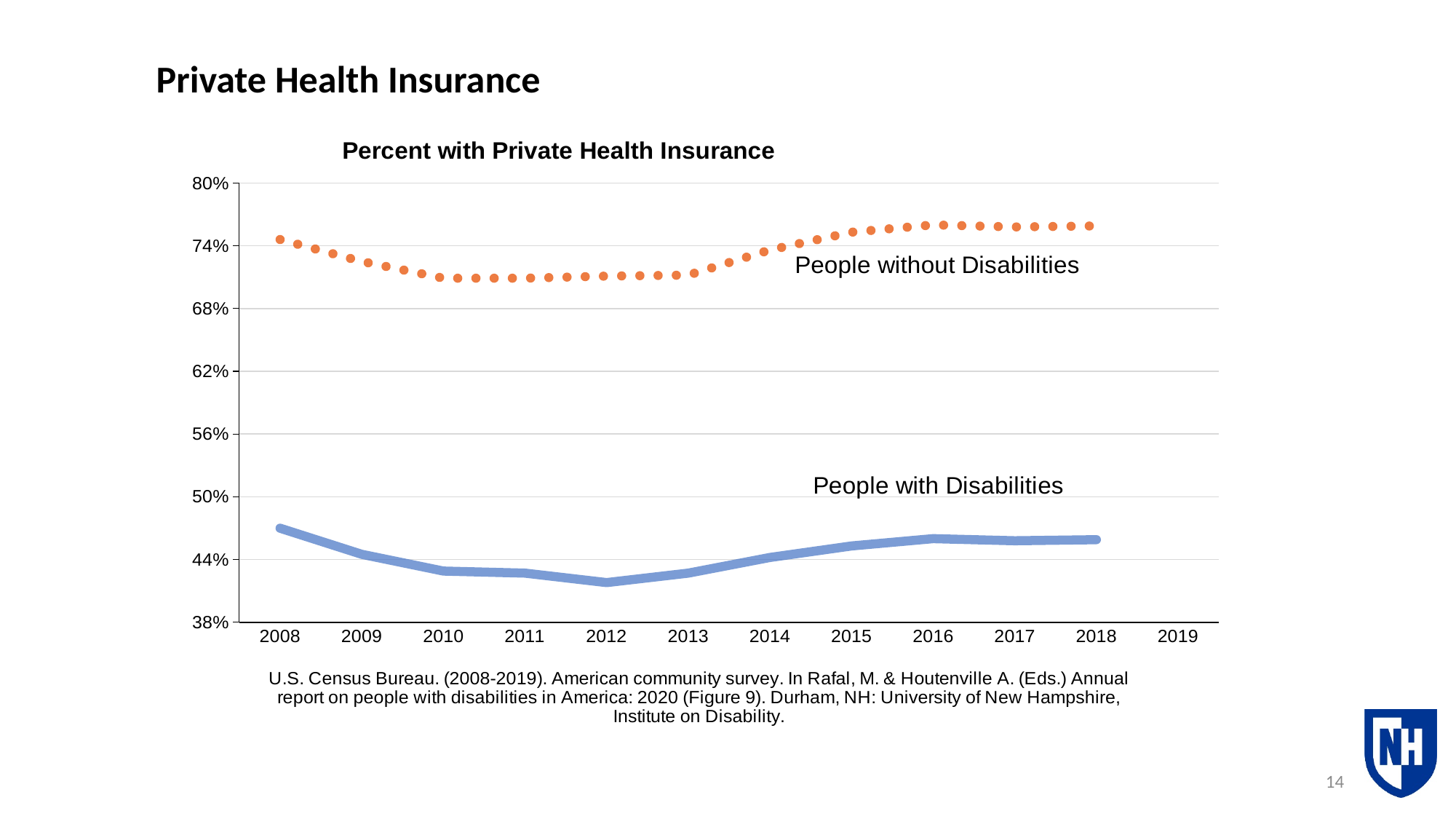
Does the People with Disabilities line rise or fall from 2008 to 2012? fall Is the value for People with Disabilities in 2008 greater or less than 44%? greater How many years are labeled on the x axis? 12 Is the value for People without Disabilities in 2010 greater or less than 74%? less Is the value for People with Disabilities in 2012 greater or less than 44%? less Which series is drawn with a dotted orange line? People without Disabilities What kind of chart is shown on the slide? line chart In 2012, which series has the higher value, People with Disabilities or People without Disabilities? People without Disabilities What is the title of the chart? Percent with Private Health Insurance In which year is the People with Disabilities line at its lowest? 2012 How many series are plotted in the chart? 2